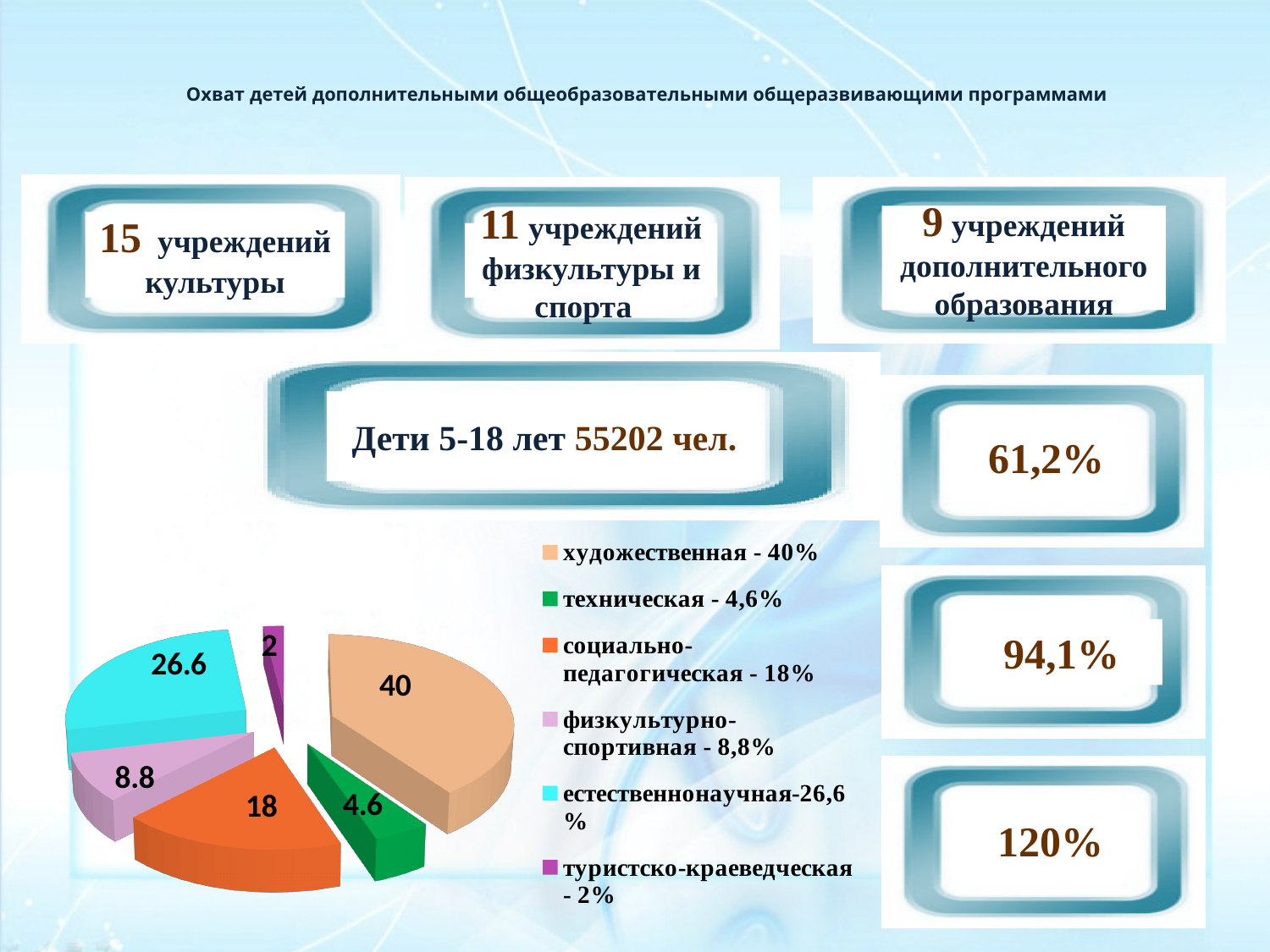
Which slice is larger: физкультурно-спортивная or техническая? физкультурно-спортивная What share of the pie does the художественная category represent, according to the legend? 40% What value is labelled on the туристско-краеведческая slice of the pie chart? 2 What value is labelled on the естественнонаучная slice of the pie chart? 26.6 What value is labelled on the социально-педагогическая slice of the pie chart? 18 What colour is the техническая slice in the pie chart? green How many slices does the pie chart have? 6 What is the difference between the художественная slice (40) and the естественнонаучная slice (26.6)? 13.4 What is the difference between the социально-педагогическая slice (18) and the физкультурно-спортивная slice (8.8)? 9.2 What kind of chart is shown on the slide? pie chart Which category has the largest slice in the pie chart? художественная Which category has the smallest slice in the pie chart? туристско-краеведческая